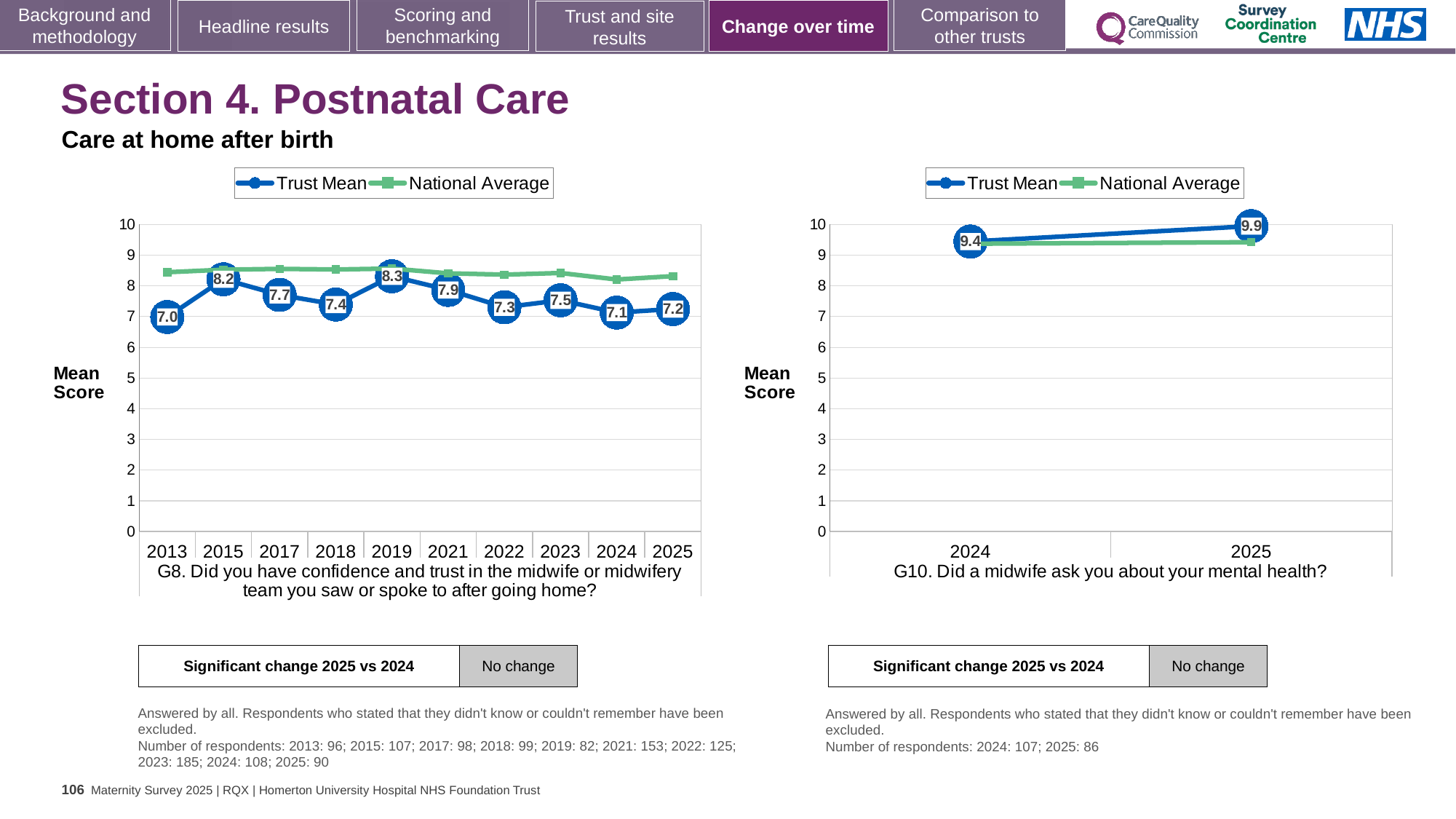
In the G8 chart, which year has the lowest Trust Mean score? 2013 In the G10 chart, does the Trust Mean rise or fall from 2024 to 2025? Rise In the G8 chart, is the Trust Mean score higher in 2021 or in 2022? 2021 In the G8 chart, what is the difference between the Trust Mean scores for 2015 and 2018? 0.8 In the G8 chart, which year has the highest Trust Mean score? 2019 What kind of chart is the G10 chart? Line chart How many series does the legend of the G10 chart list? 2 In the G8 chart, what is the Trust Mean score for 2013? 7.0 In the G8 chart, what is the Trust Mean score for 2019? 8.3 In the G8 chart, is the National Average value for 2013 greater or less than 8? greater How many years are plotted on the x axis of the G8 chart? 10 In the G10 chart, what is the difference between the Trust Mean scores for 2025 and 2024? 0.5